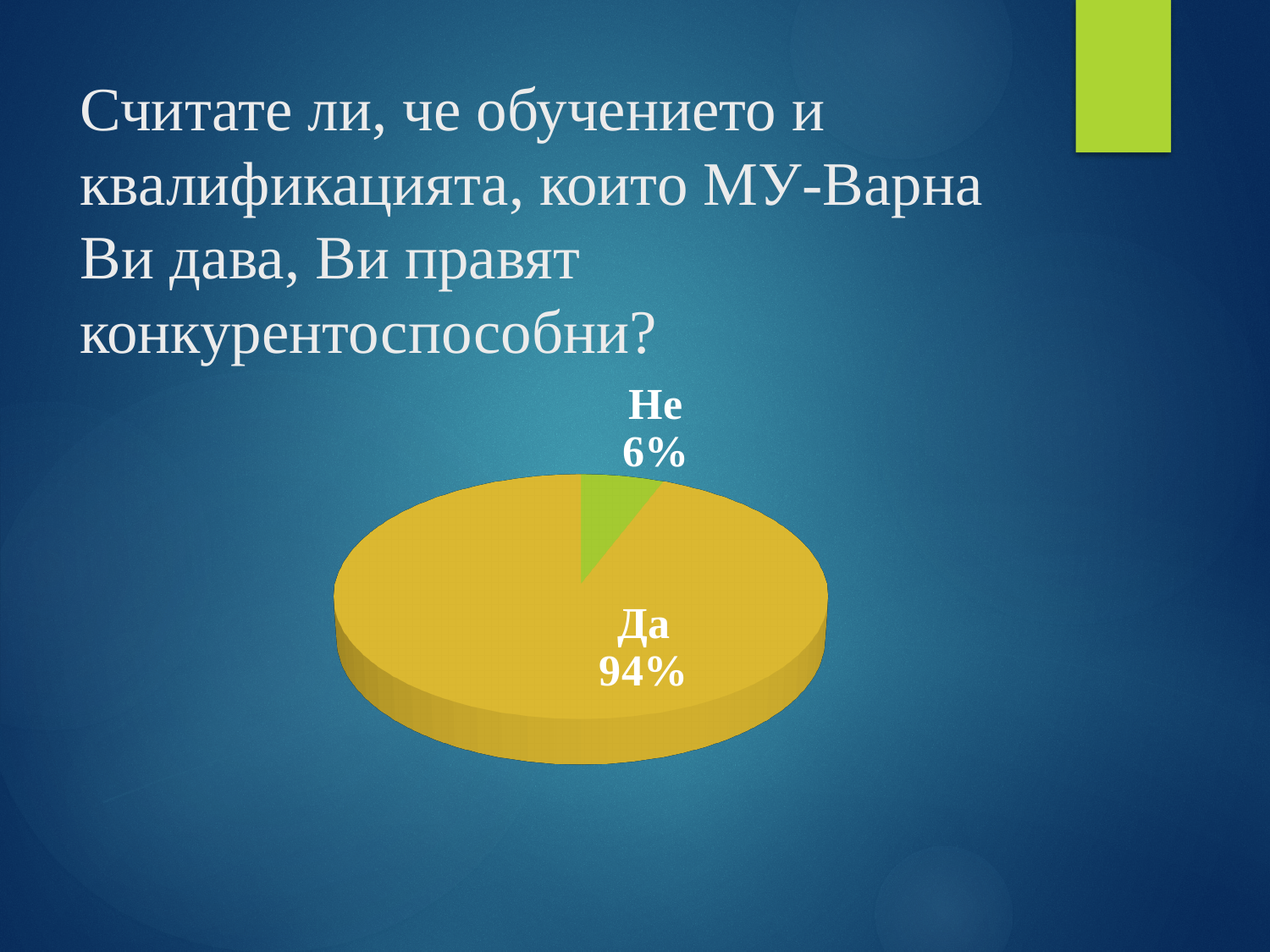
How many slices does the pie chart have? 2 What colour is the "Да" slice? yellow What colour is the "Не" slice? green What percentage of respondents answered "Да"? 94% What kind of chart is shown on the slide? pie chart Which is larger, the "Да" slice or the "Не" slice? Да What is the difference in percentage points between the "Да" and "Не" slices? 88 What share of the pie does the "Не" slice represent? 6% What percentage of respondents answered "Не"? 6% Which slice of the pie is the smallest? Не Which slice of the pie is the largest? Да